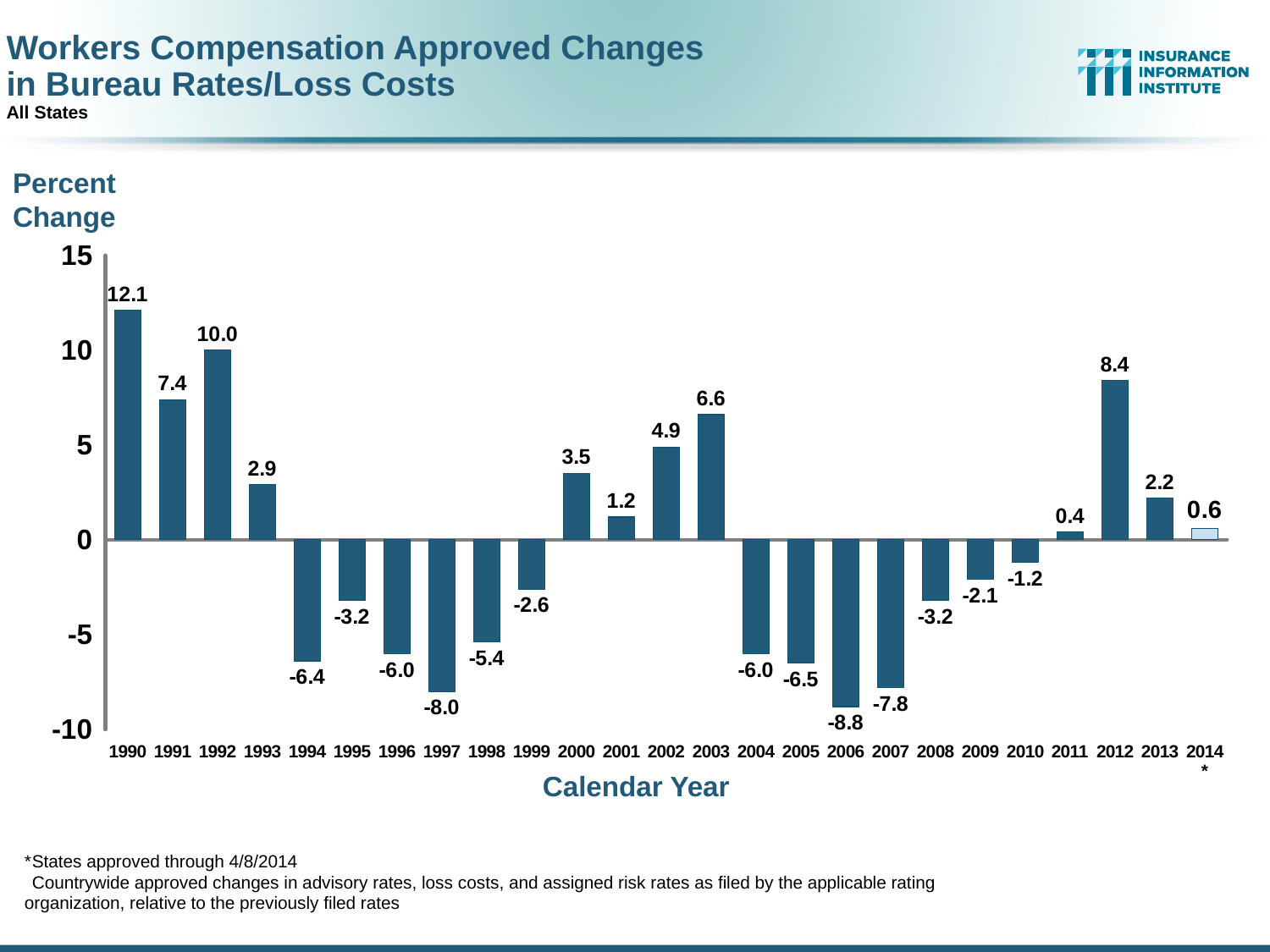
What is the percent change shown for 2006? -8.8 Which year has a larger percent change, 1992 or 2003? 1992 Which calendar year has the lowest percent change? 2006 What is the percent change shown for 2014? 0.6 What is the difference between the percent change in 2012 and the percent change in 2013? 6.2 Which calendar year has the highest percent change? 1990 What is the percent change shown for 1990? 12.1 What kind of chart is shown on the slide? bar chart Is the value for 1997 greater or less than -5? less How many calendar years are shown on the x axis? 25 Do the values rise or fall from 2010 to 2012? rise What is the label of the x axis? Calendar Year